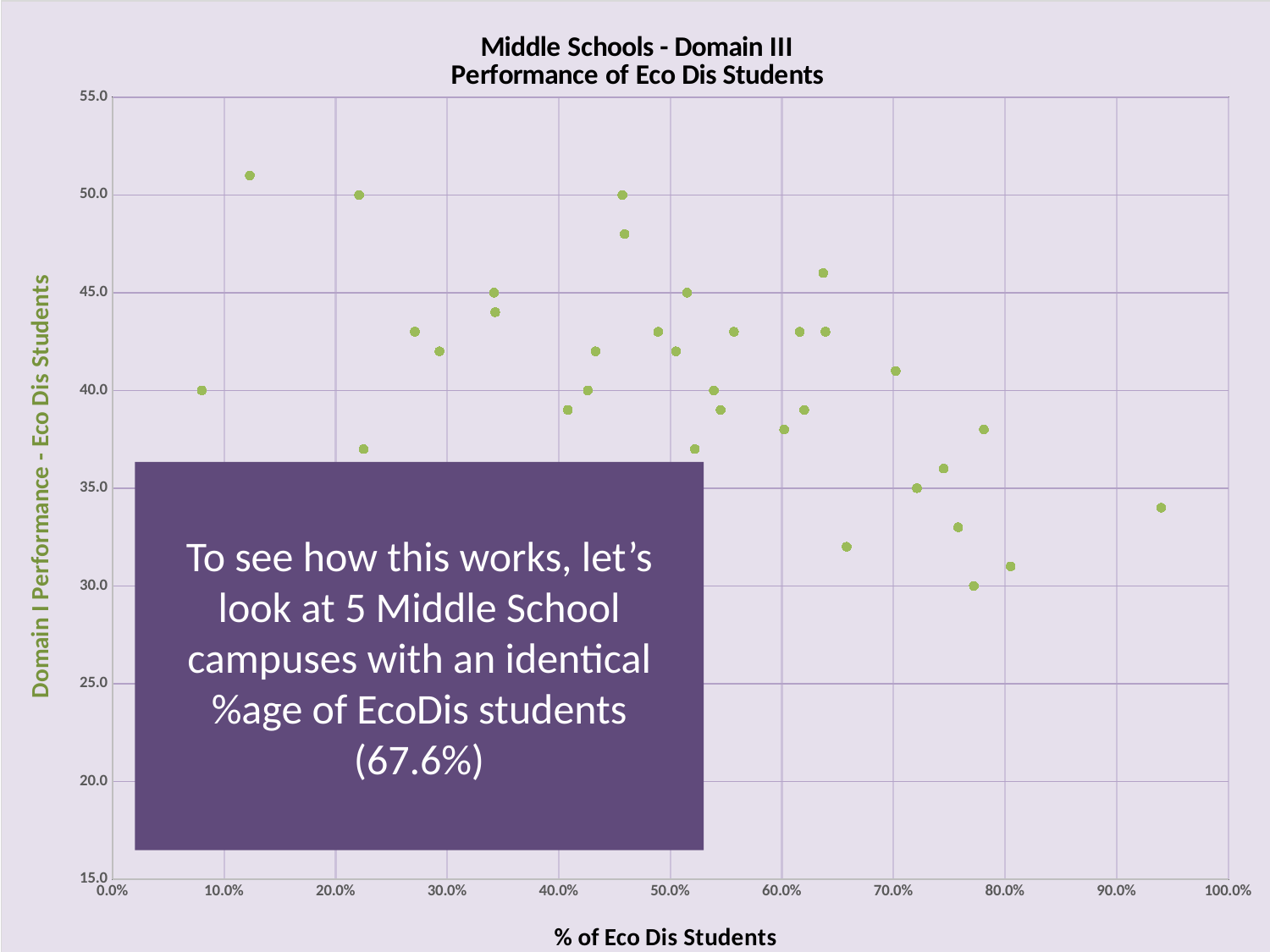
Is the highest plotted Domain I Performance value greater or less than 50? greater What is the label of the vertical axis? Domain I Performance - Eco Dis Students Is the lowest plotted Domain I Performance value greater or less than 25? greater What kind of chart is shown on the slide? scatter chart Is the Domain I Performance value of the rightmost point (highest % of Eco Dis Students) greater or less than 35? less As the % of Eco Dis Students increases along the x axis, do the Domain I Performance values generally rise or fall? fall What is the title of the chart? Middle Schools - Domain III Performance of Eco Dis Students